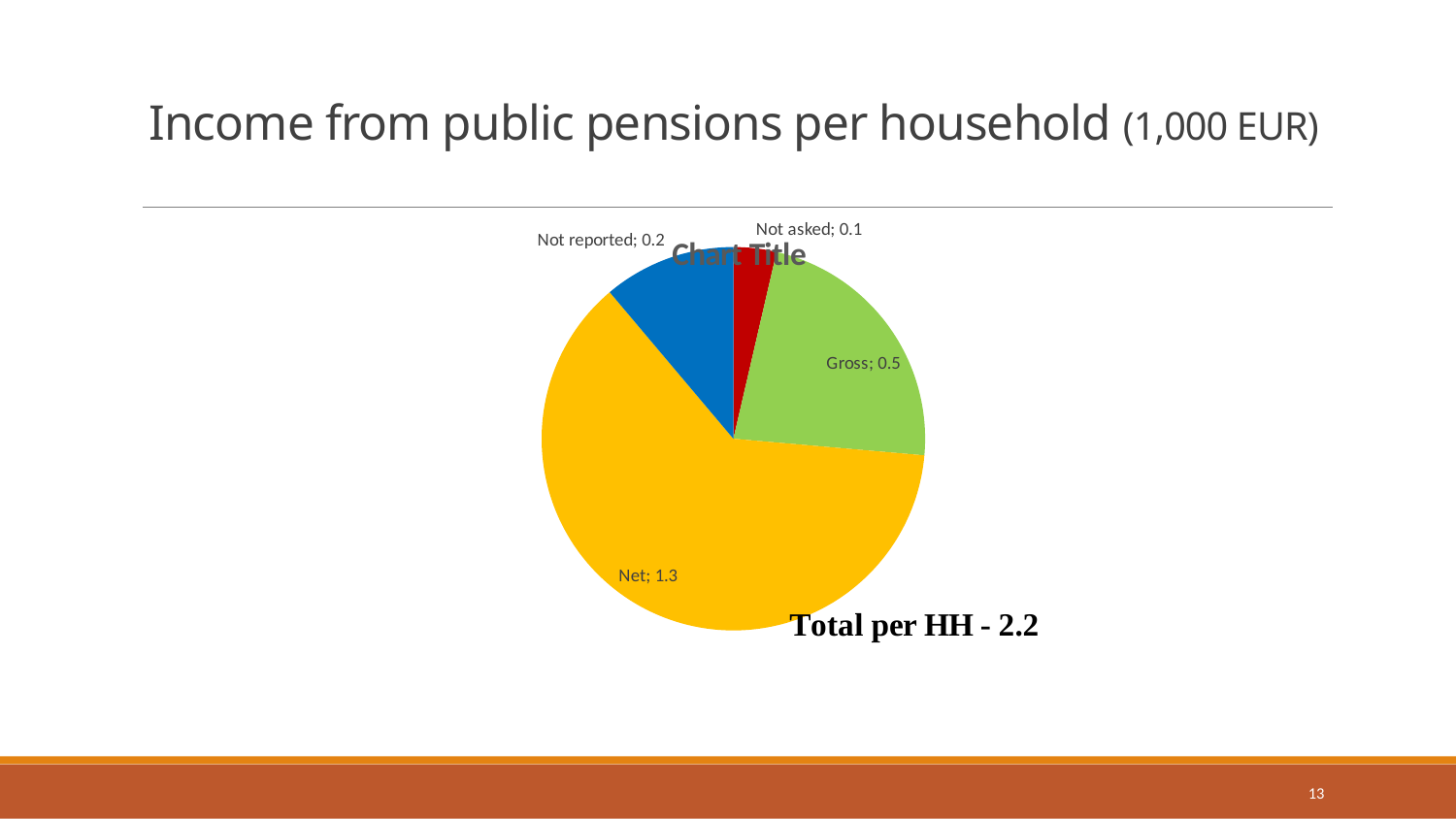
What is the difference between the Net and Gross values? 0.8 What is the value for Not reported in the pie chart? 0.2 What is the value for Gross in the pie chart? 0.5 What total per household is stated on the slide? 2.2 How many slices does the pie chart have? 4 Which is larger, Gross or Not reported? Gross What is the value for Net in the pie chart? 1.3 What type of chart is shown on the slide? Pie chart What colour is the Net slice in the pie chart? Yellow What is the value for Not asked in the pie chart? 0.1 Which category has the largest slice in the pie chart? Net Which category has the smallest slice in the pie chart? Not asked